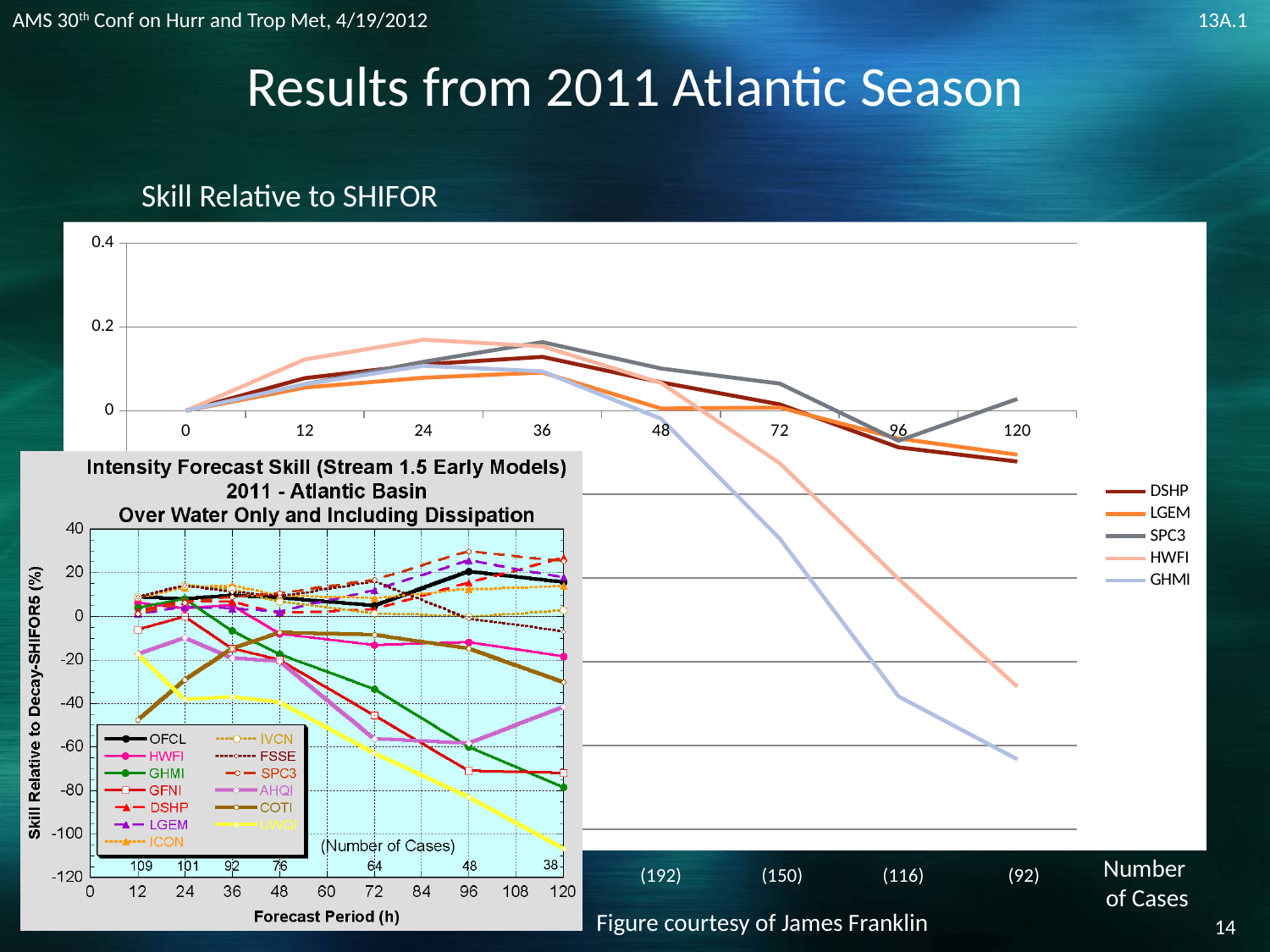
In the 'Skill Relative to SHIFOR' chart, what number of cases is shown beneath the 120 h point? (92) In the 'Skill Relative to SHIFOR' chart, which is higher at 120 h, SPC3 or HWFI? SPC3 In the 'Skill Relative to SHIFOR' chart, is the HWFI value at 24 h greater or less than 0.2? less In the inset 'Intensity Forecast Skill (Stream 1.5 Early Models)' chart, what is the number of cases at 12 h? 109 In the 'Skill Relative to SHIFOR' chart, does the GHMI series rise or fall from 48 h to 120 h? fall In the 'Skill Relative to SHIFOR' chart, is the GHMI value at 120 h greater or less than 0? less In the 'Skill Relative to SHIFOR' chart, which series has the lowest value at 120 h? GHMI How many series does the legend of the 'Skill Relative to SHIFOR' chart list? 5 In the 'Skill Relative to SHIFOR' chart, which series has the highest value at 24 h? HWFI In the 'Skill Relative to SHIFOR' chart, is the SPC3 value at 120 h greater or less than 0? greater What kind of chart is the 'Skill Relative to SHIFOR' chart? line chart How many forecast-hour points are labelled on the x axis of the 'Skill Relative to SHIFOR' chart? 8